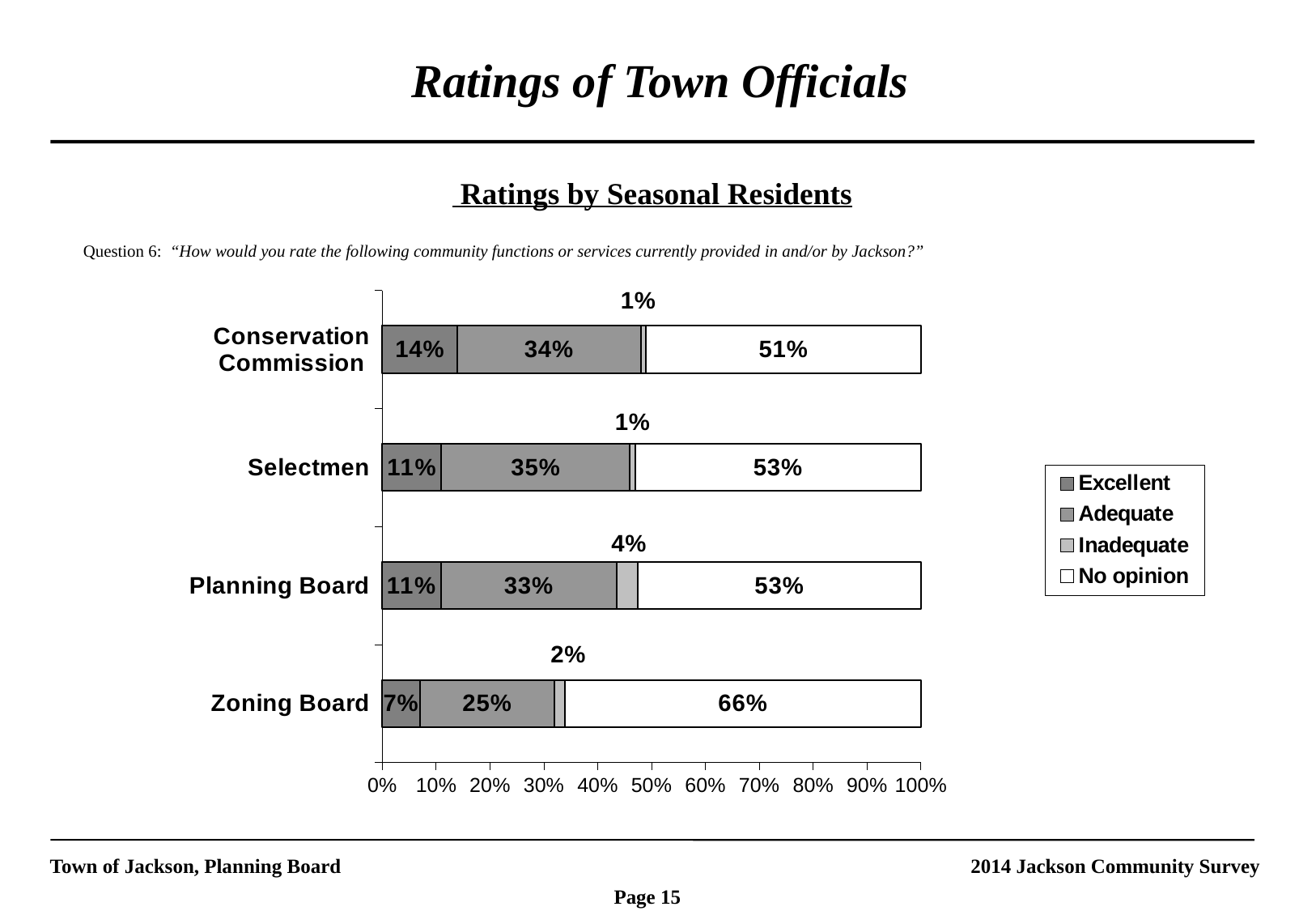
How many series does the legend list? 4 Which is larger, the Adequate value for the Conservation Commission or the Adequate value for the Zoning Board? Conservation Commission How many town officials (categories) are rated in the chart? 4 What percentage of seasonal residents rated the Conservation Commission as Excellent? 14% Which town official has the highest Excellent rating? Conservation Commission What is the No opinion value for the Zoning Board? 66% What is the difference between the No opinion values for the Zoning Board and the Selectmen? 13% Which legend entry is shown in white? No opinion Which town official has the lowest Adequate rating? Zoning Board What kind of chart is shown on the slide? stacked bar chart What is the Adequate value for the Selectmen? 35% What is the Inadequate value for the Planning Board? 4%